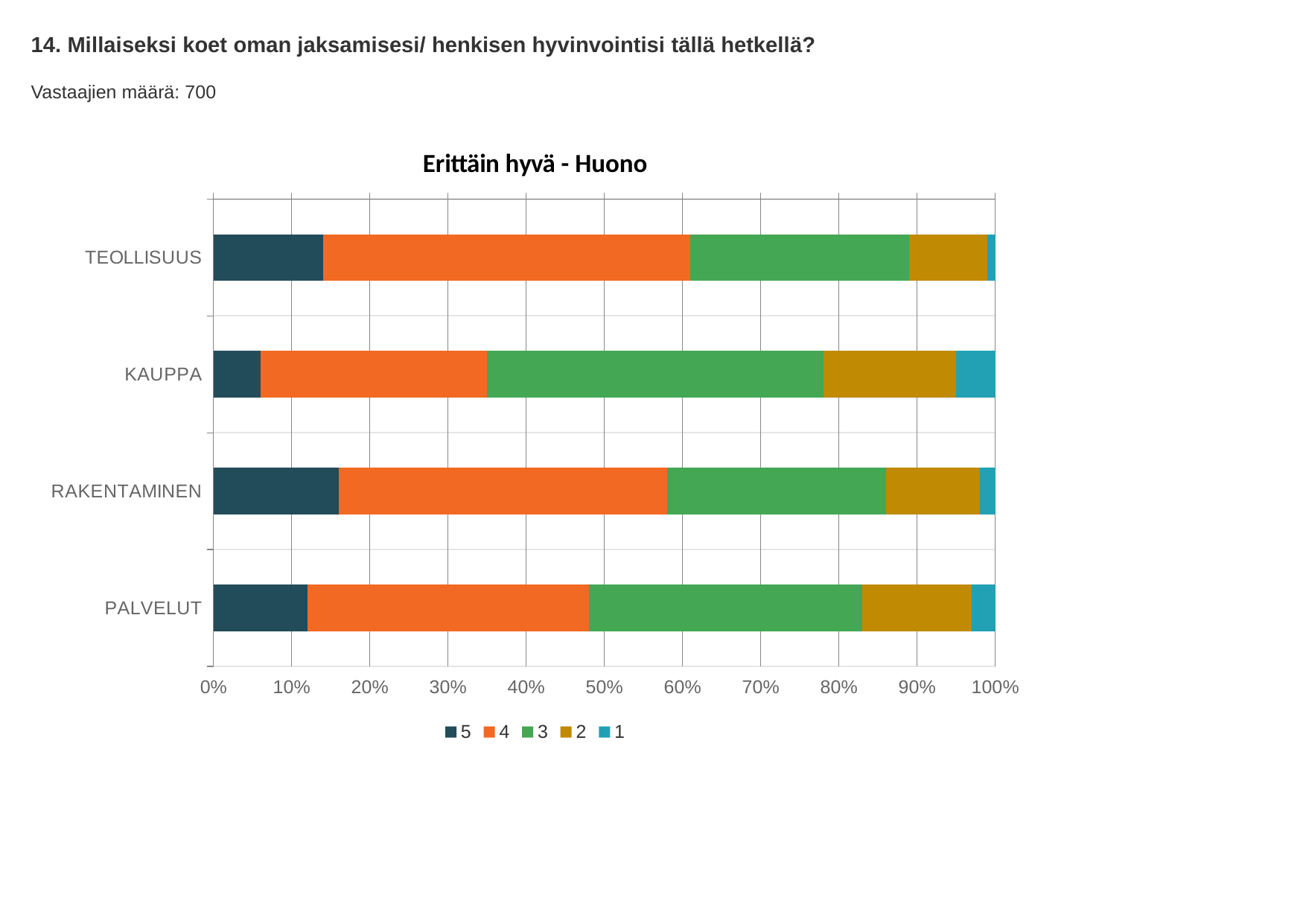
What is the title of the chart? Erittäin hyvä - Huono What kind of chart is shown on the slide? bar chart Which category has the smallest segment for series 5? KAUPPA How many categories are shown on the vertical axis of the chart? 4 Is the series 5 segment for KAUPPA greater or less than 10%? less Is the series 5 segment for RAKENTAMINEN greater or less than 10%? greater Is the series 4 segment for TEOLLISUUS greater or less than 40%? greater How many respondents (Vastaajien määrä) are reported on the slide? 700 Which is larger: the series 5 segment for RAKENTAMINEN or the series 5 segment for KAUPPA? RAKENTAMINEN How many series does the legend list? 5 Which category has the largest segment for series 1? KAUPPA Which category has the largest segment for series 3? KAUPPA